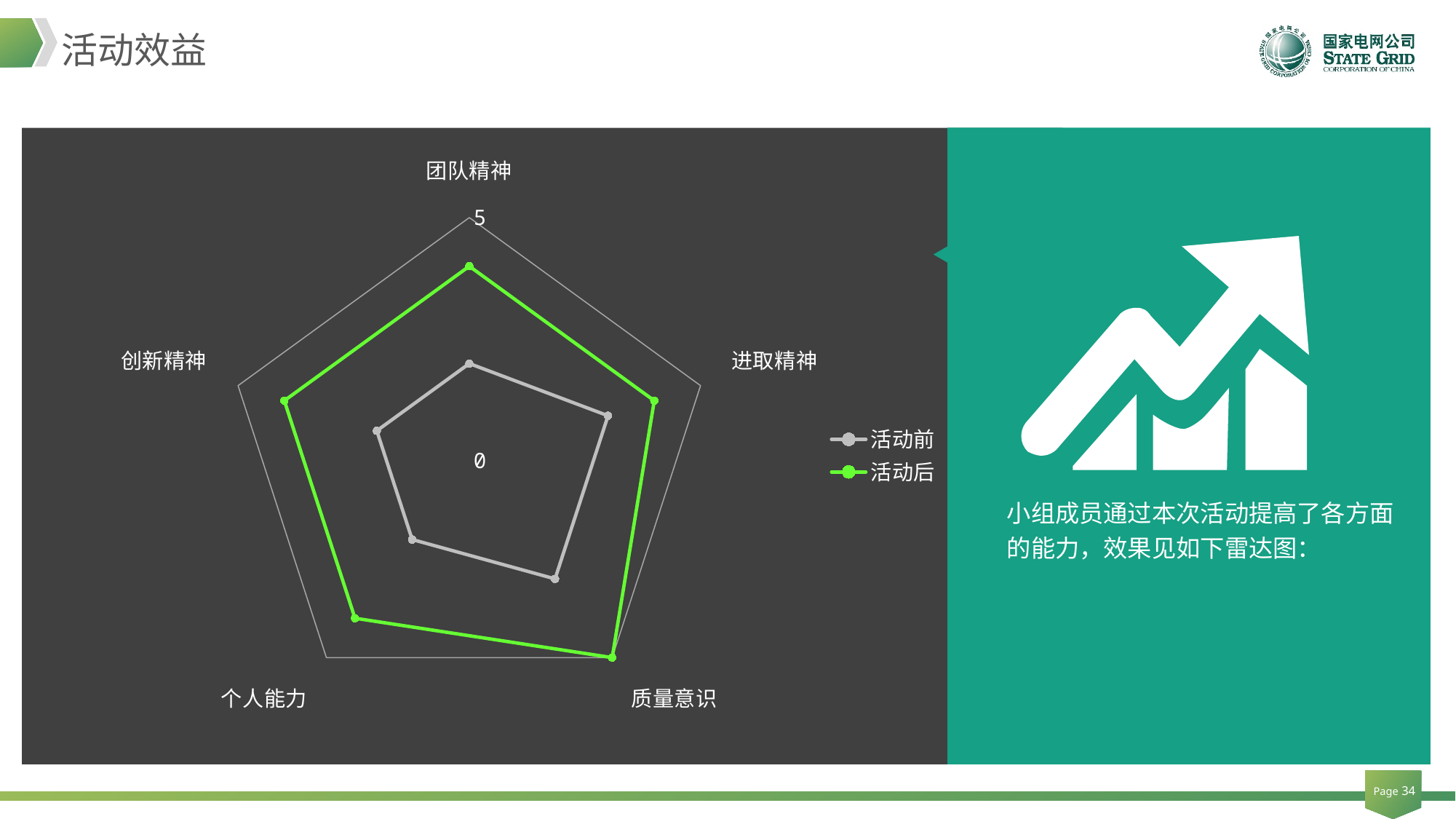
For 创新精神, which series has the larger value, 活动前 or 活动后? 活动后 How many categories (axes) does the radar chart have? 5 What colour is the 活动后 series drawn in on the radar chart? Green What kind of chart is shown on the slide? Radar chart For 团队精神, which series has the larger value, 活动前 or 活动后? 活动后 What is the value of 质量意识 for the 活动后 series? 5 Is the value for 团队精神 in the 活动前 series greater or less than 5? less Which category has the highest value for the 活动后 series? 质量意识 For 个人能力, which series has the larger value, 活动前 or 活动后? 活动后 What are the two series named in the legend of the radar chart? 活动前 and 活动后 How many series does the legend of the radar chart list? 2 Is the value for 进取精神 in the 活动后 series greater or less than 0? greater